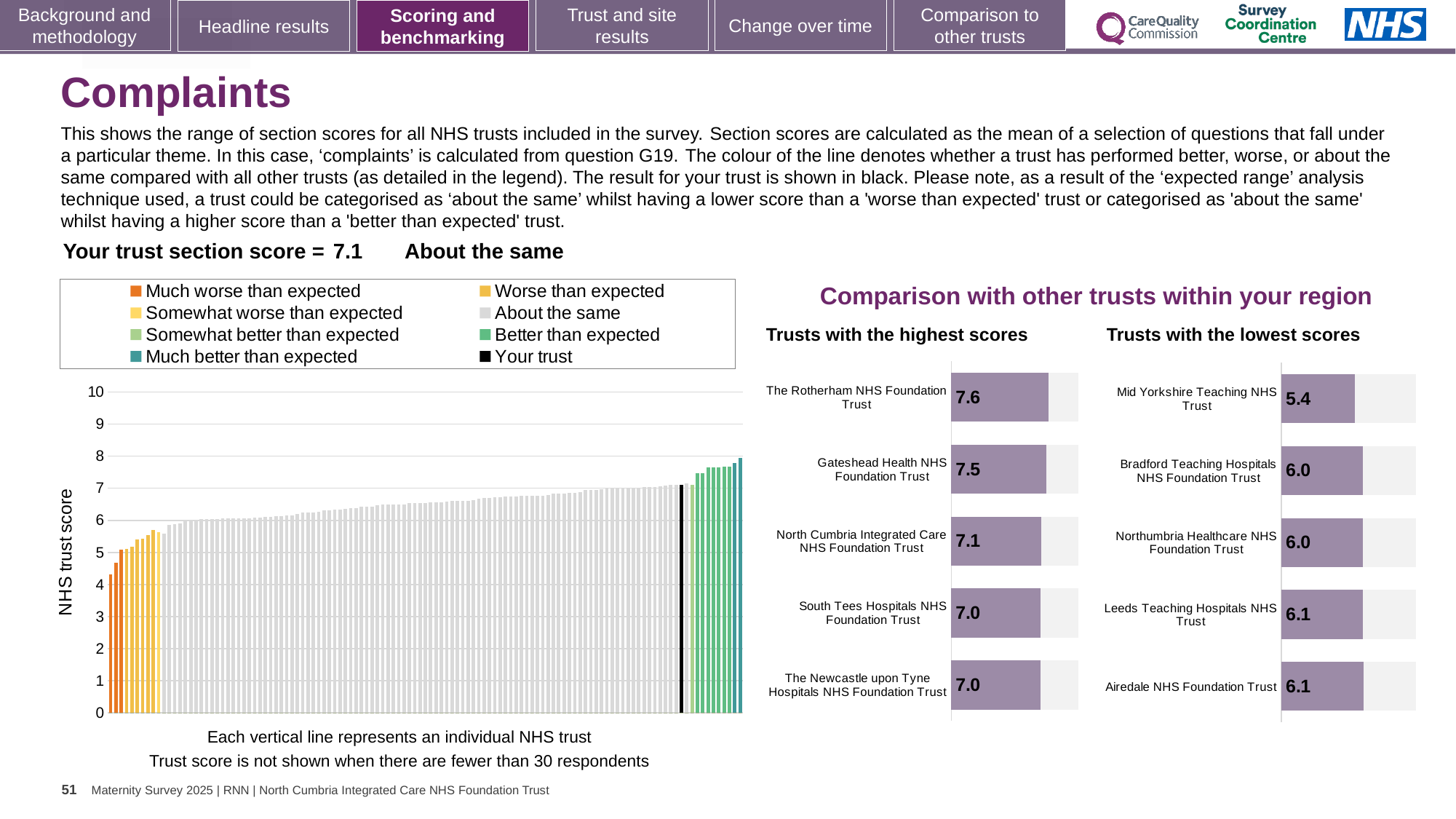
In the 'Trusts with the highest scores' chart, which trust has the highest score? The Rotherham NHS Foundation Trust In the 'Trusts with the highest scores' chart, what is the difference between the scores of The Rotherham NHS Foundation Trust and North Cumbria Integrated Care NHS Foundation Trust? 0.5 In the 'Trusts with the lowest scores' chart, what is the score for Leeds Teaching Hospitals NHS Trust? 6.1 In the 'Trusts with the highest scores' chart, what is the score for Gateshead Health NHS Foundation Trust? 7.5 In the 'Trusts with the highest scores' chart, what is the score for The Rotherham NHS Foundation Trust? 7.6 How many trusts are shown in the 'Trusts with the lowest scores' chart? 5 In the 'Trusts with the lowest scores' chart, what is the score for Mid Yorkshire Teaching NHS Trust? 5.4 Which is larger: the score for Gateshead Health NHS Foundation Trust in the highest scores chart or the score for Bradford Teaching Hospitals NHS Foundation Trust in the lowest scores chart? Gateshead Health NHS Foundation Trust In the large chart on the left showing the range of section scores, is the value of the lowest bar greater or less than 5? less In the 'Trusts with the lowest scores' chart, what is the difference between the scores of Airedale NHS Foundation Trust and Mid Yorkshire Teaching NHS Trust? 0.7 In the 'Trusts with the lowest scores' chart, which trust has the lowest score? Mid Yorkshire Teaching NHS Trust In the large chart on the left showing the range of section scores, do the bar values rise or fall from left to right? rise